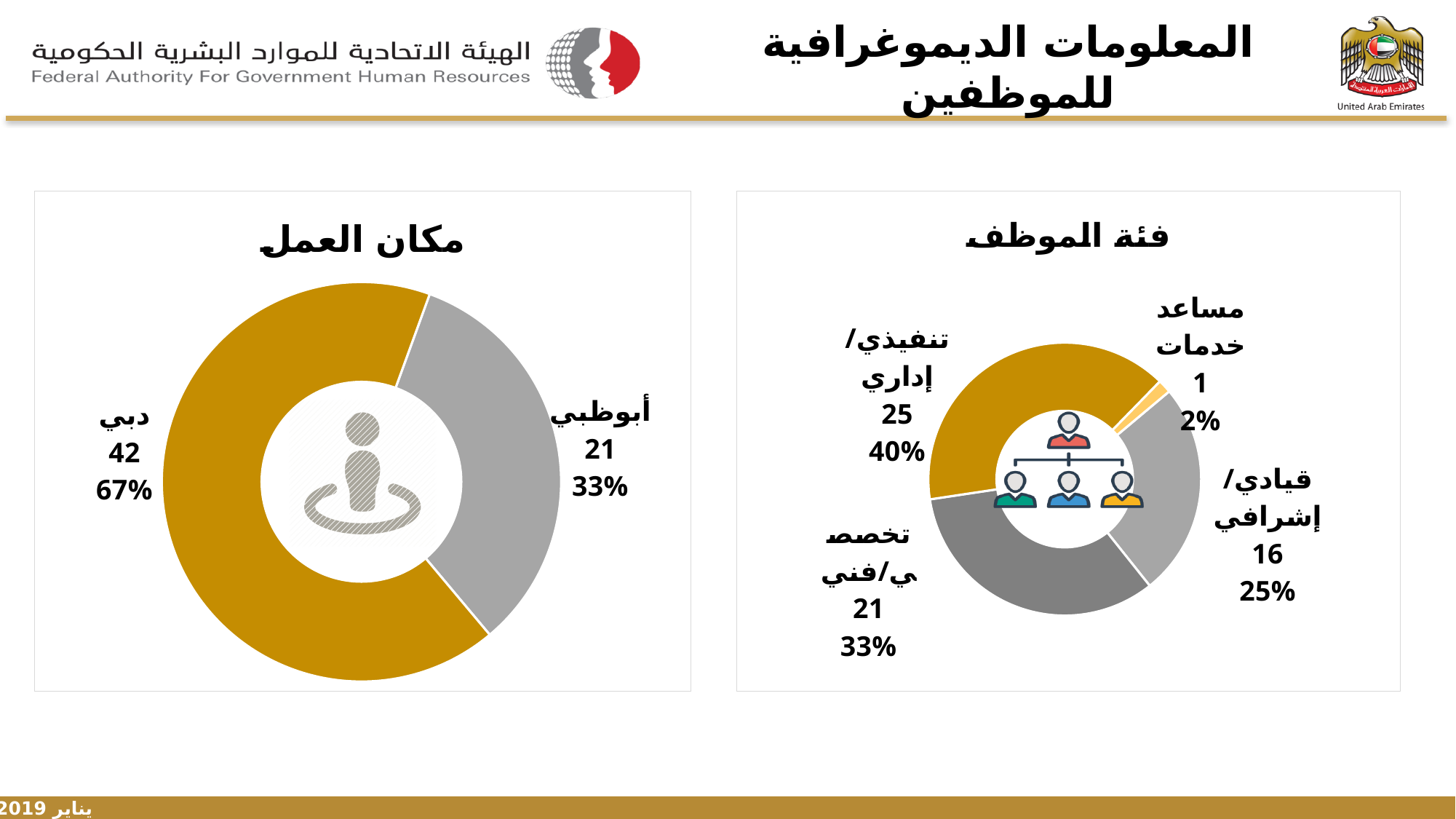
In the chart titled "فئة الموظف", which category has the largest value? تنفيذي/إداري In the chart titled "مكان العمل", which category has the larger value? دبي In the chart titled "فئة الموظف", what is the value for قيادي/إشرافي? 16 In the chart titled "فئة الموظف", what is the value for تنفيذي/إداري? 25 In the chart titled "فئة الموظف", what percentage share does تخصصي/فني have? 33% In the chart titled "فئة الموظف", how many categories are shown? 4 In the chart titled "مكان العمل", how many categories are shown? 2 In the chart titled "مكان العمل", what is the difference between the values for دبي and أبوظبي? 21 In the chart titled "مكان العمل", what percentage share does أبوظبي have? 33% In the chart titled "مكان العمل", what is the value for دبي? 42 In the chart titled "فئة الموظف", which category has the smallest value? مساعد خدمات What type of chart is the chart titled "فئة الموظف"? Doughnut chart